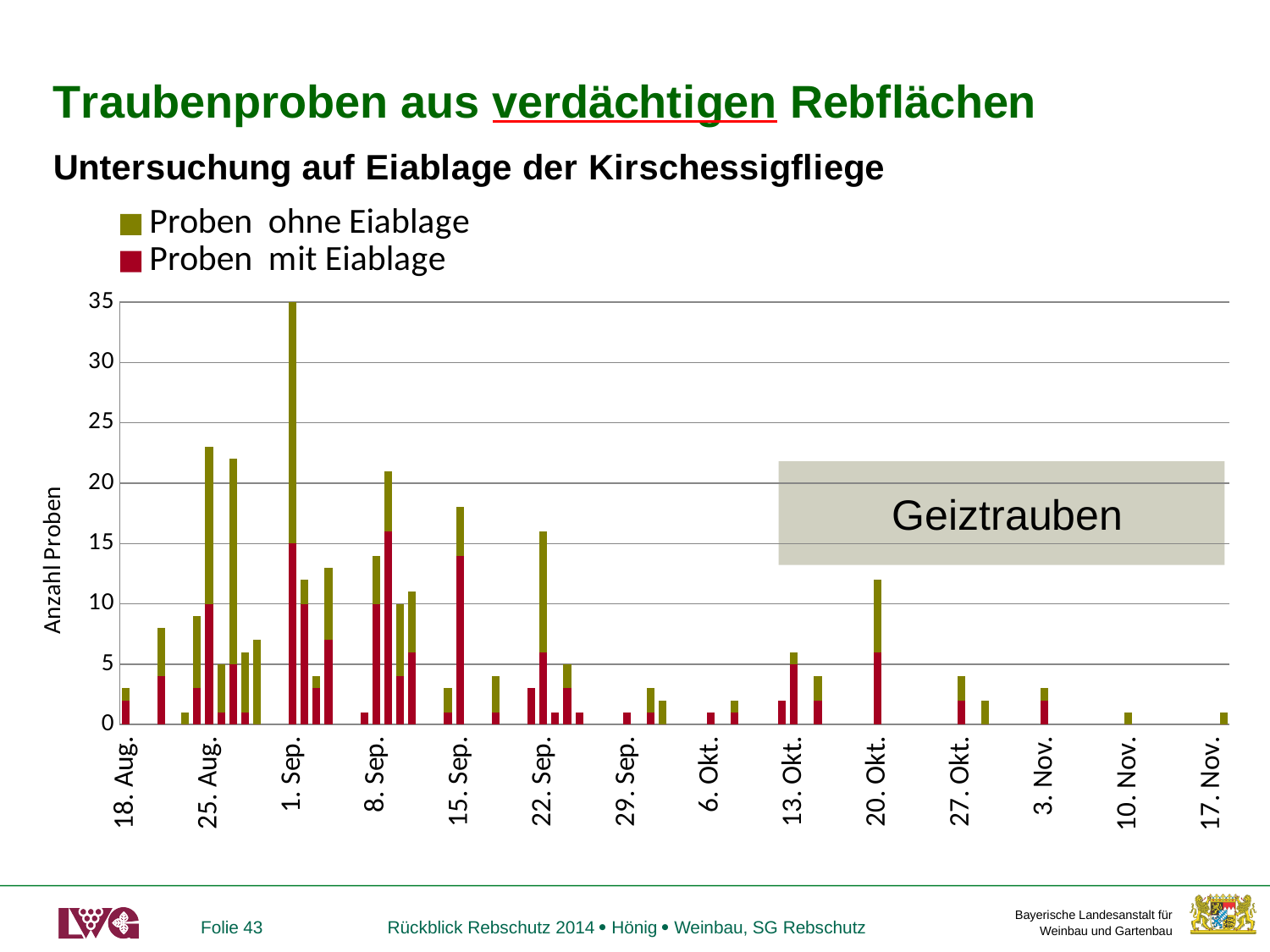
Is the total of the bar at 1. Sep. greater or less than 30? greater How many series does the legend list? 2 What kind of chart is shown on the slide? bar chart At which date label is the tallest stacked bar? 1. Sep. Is the total of the bar at 17. Nov. greater or less than 5? less Which stacked bar is taller, the one at 1. Sep. or the one at 20. Okt.? 1. Sep. Is the total of the bar at 20. Okt. greater or less than 10? greater What is the label of the vertical axis? Anzahl Proben What are the two series named in the legend? Proben ohne Eiablage; Proben mit Eiablage Do the bar totals generally rise or fall from early September to November? fall What value does the tallest bar (at 1. Sep.) reach on the vertical axis? 35